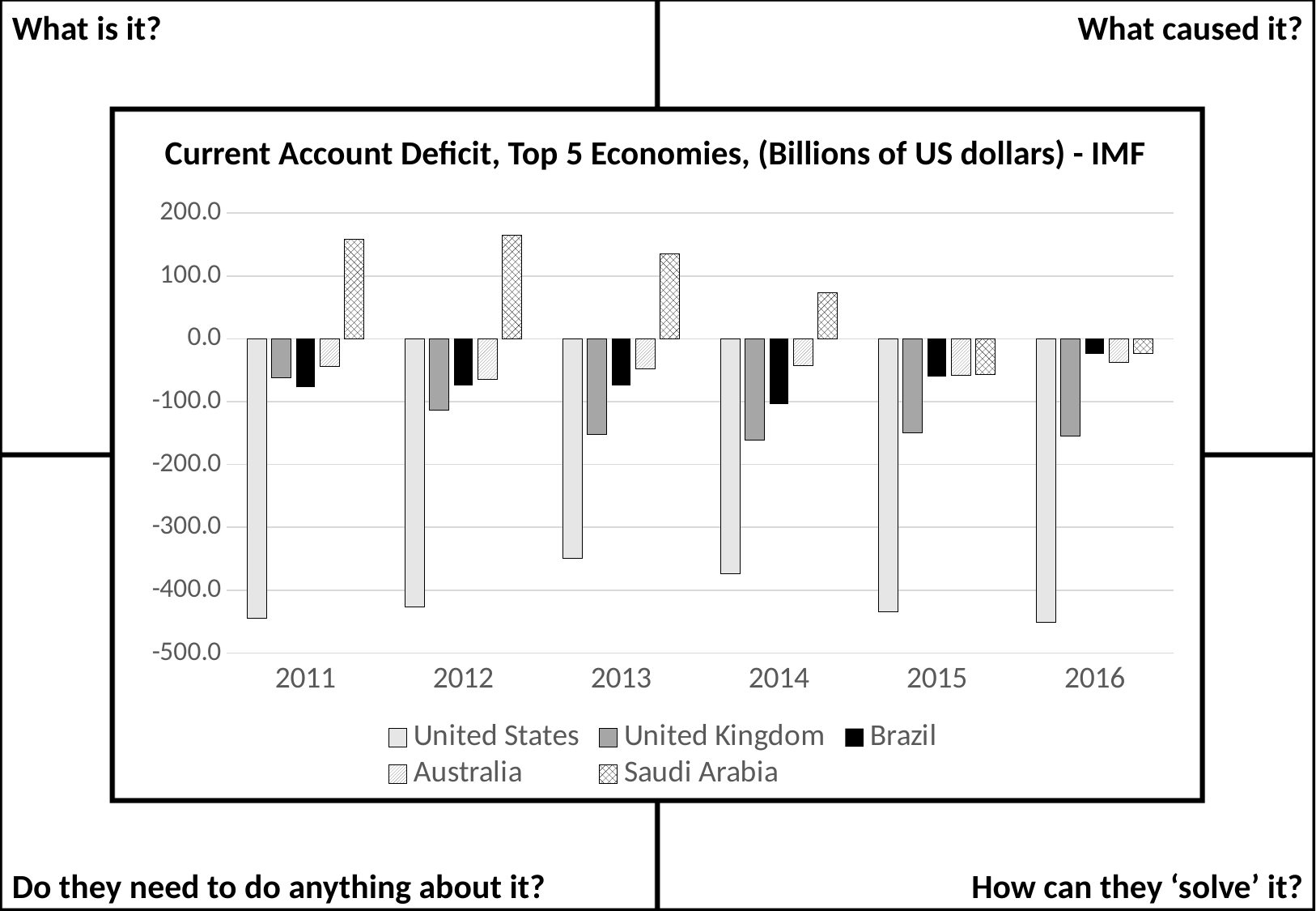
What is the title of the chart? Current Account Deficit, Top 5 Economies, (Billions of US dollars) - IMF What kind of chart is shown on the slide? Bar chart Is the value for Brazil in 2016 greater or less than -50.0? greater Is the value for Saudi Arabia in 2012 greater or less than 100.0? greater Do the values for Saudi Arabia rise or fall from 2011 to 2016? fall Which series has the lowest value in 2013? United States Which series has the highest value in 2011? Saudi Arabia Which is larger: the value for Saudi Arabia in 2013 or in 2014? 2013 Is the value for United Kingdom in 2013 greater or less than -100.0? less How many series does the legend list? 5 How many years are shown on the x axis? 6